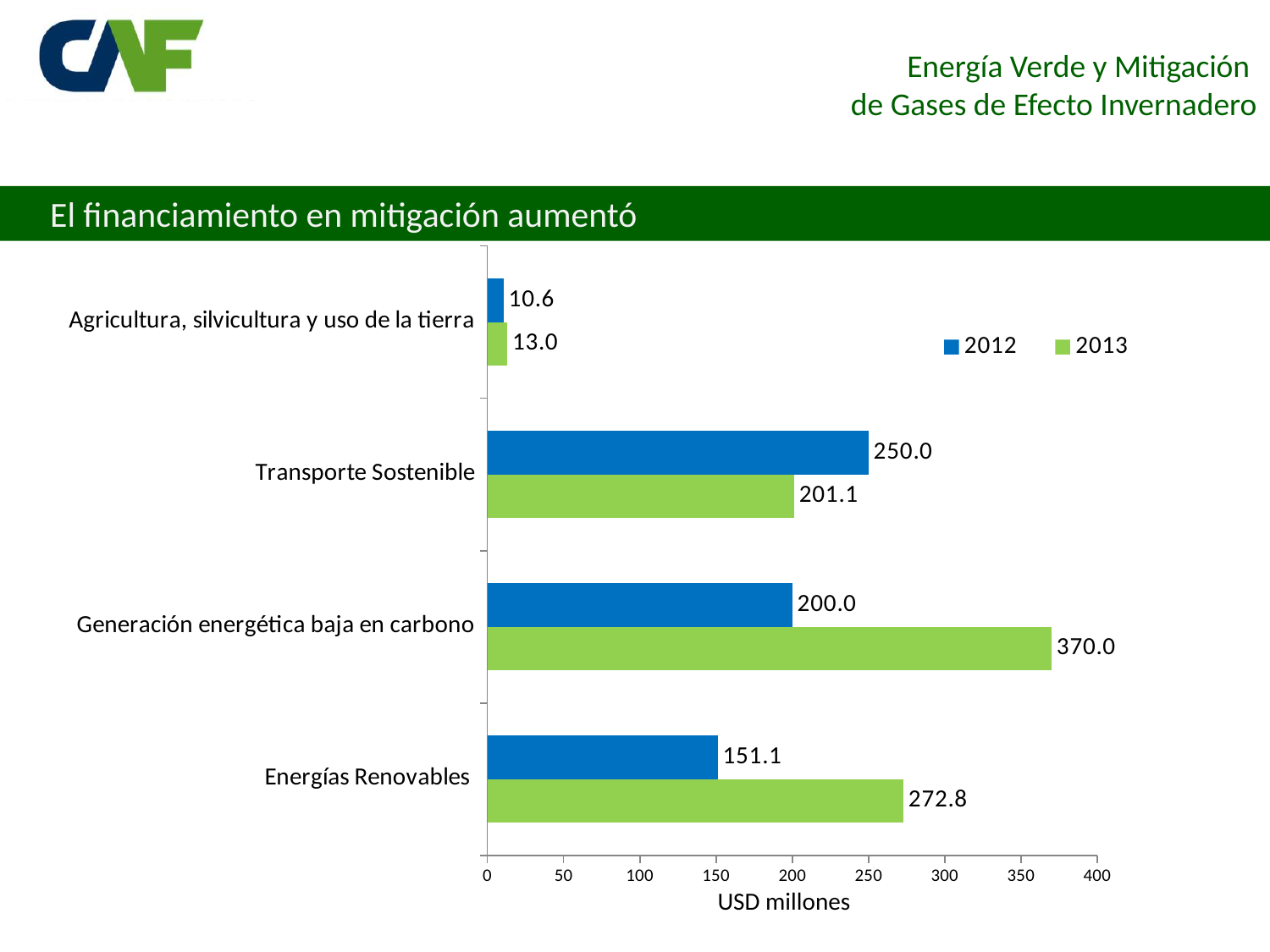
What is the 2012 value for Energías Renovables? 151.1 What is the 2012 value for Agricultura, silvicultura y uso de la tierra? 10.6 What is the 2013 value for Transporte Sostenible? 201.1 How many series does the legend list? 2 How many categories are shown on the chart? 4 For Transporte Sostenible, which year has the larger value, 2012 or 2013? 2012 Which category has the highest 2013 value? Generación energética baja en carbono What kind of chart is shown on the slide? Bar chart What is the difference between the 2013 and 2012 values for Energías Renovables? 121.7 What is the label of the x axis? USD millones Which category has the lowest 2012 value? Agricultura, silvicultura y uso de la tierra What is the 2013 value for Generación energética baja en carbono? 370.0